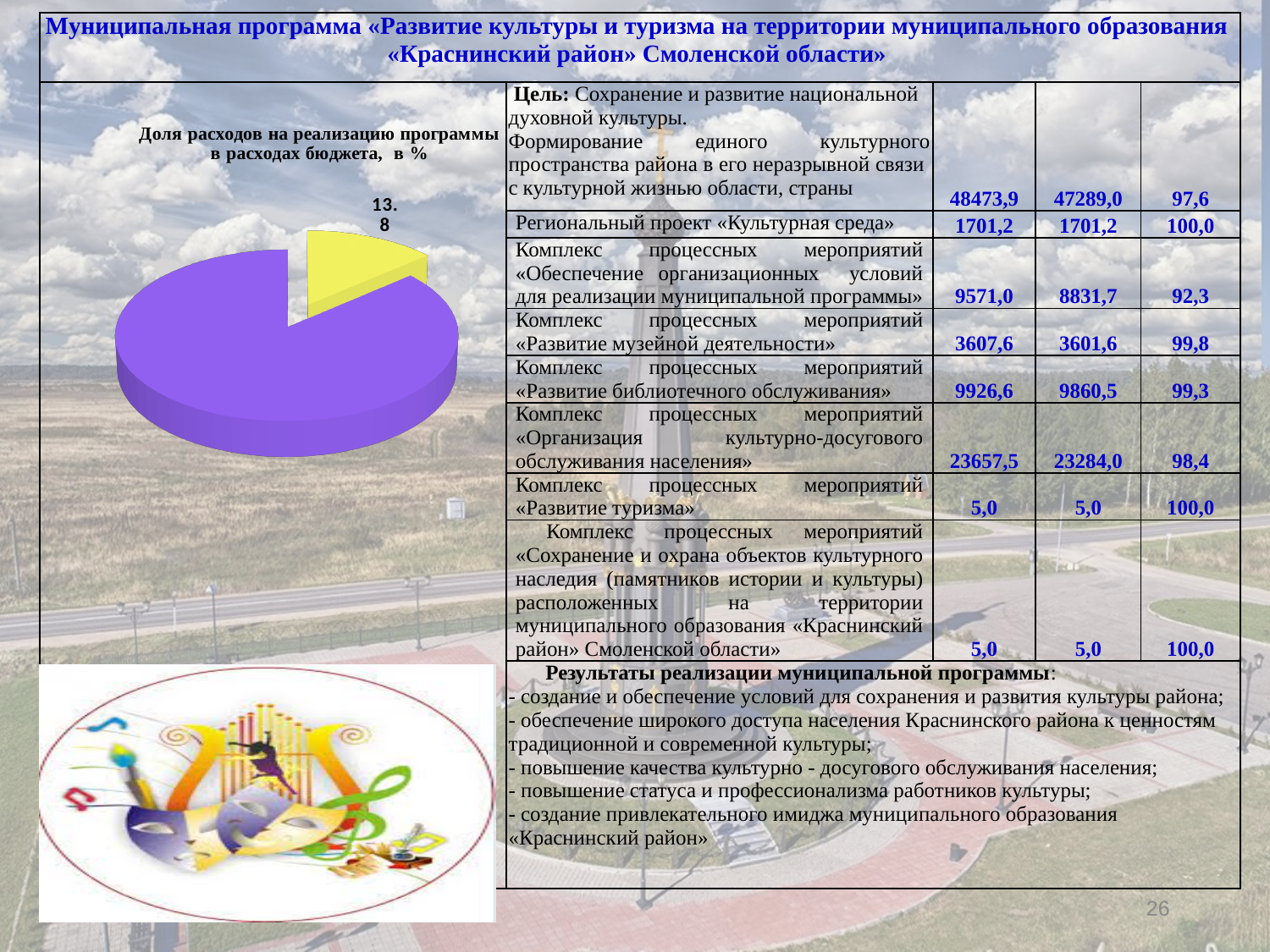
What kind of chart is shown on the left of the slide? pie chart Which slice of the pie chart is the smallest? the yellow slice (13.8) What colour is the slice labelled 13.8 in the pie chart? yellow Which slice of the pie chart is larger, the purple one or the yellow one? purple Is the value of the yellow slice in the pie chart greater or less than 50? less How many slices does the pie chart have? 2 What value is printed on the yellow slice of the pie chart? 13.8 What is the title of the pie chart? Доля расходов на реализацию программы в расходах бюджета, в %